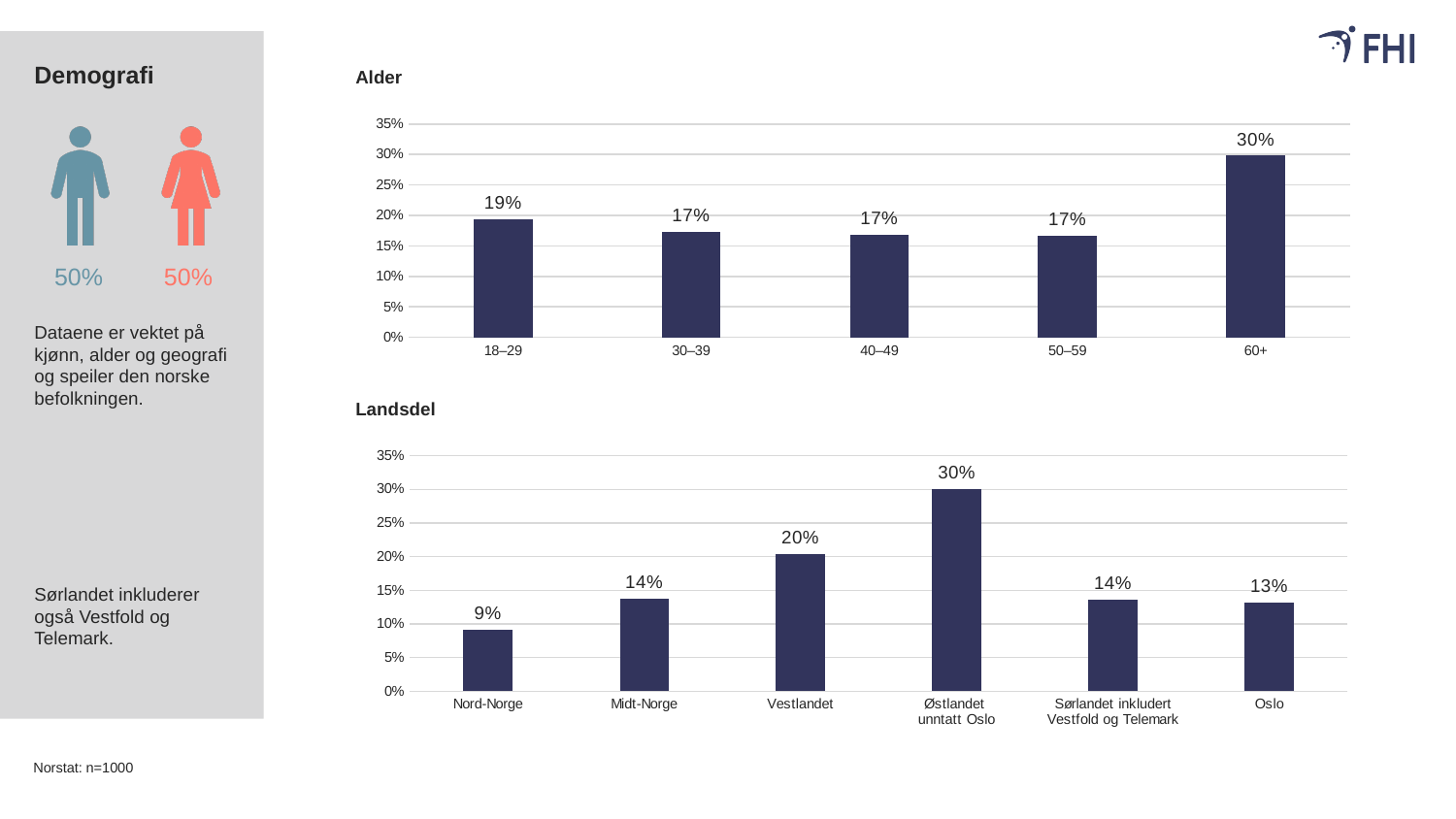
In the Landsdel chart, how many regions are shown? 6 What type of chart is the Landsdel chart? Bar chart In the Landsdel chart, what is the difference between the values for Østlandet unntatt Oslo and Nord-Norge? 21 percentage points In the Landsdel chart, what is the value for Vestlandet? 20% In the Landsdel chart, which is larger: the value for Vestlandet or the value for Oslo? Vestlandet In the Landsdel chart, which region has the lowest value? Nord-Norge In the Alder chart, what is the value for the 60+ age group? 30% In the Alder chart, how many age groups are shown? 5 In the Alder chart, what is the value for the 18–29 age group? 19% In the Landsdel chart, which region has the highest value? Østlandet unntatt Oslo In the Alder chart, which age group has the highest value? 60+ In the Alder chart, what is the difference between the values for 60+ and 18–29? 11 percentage points